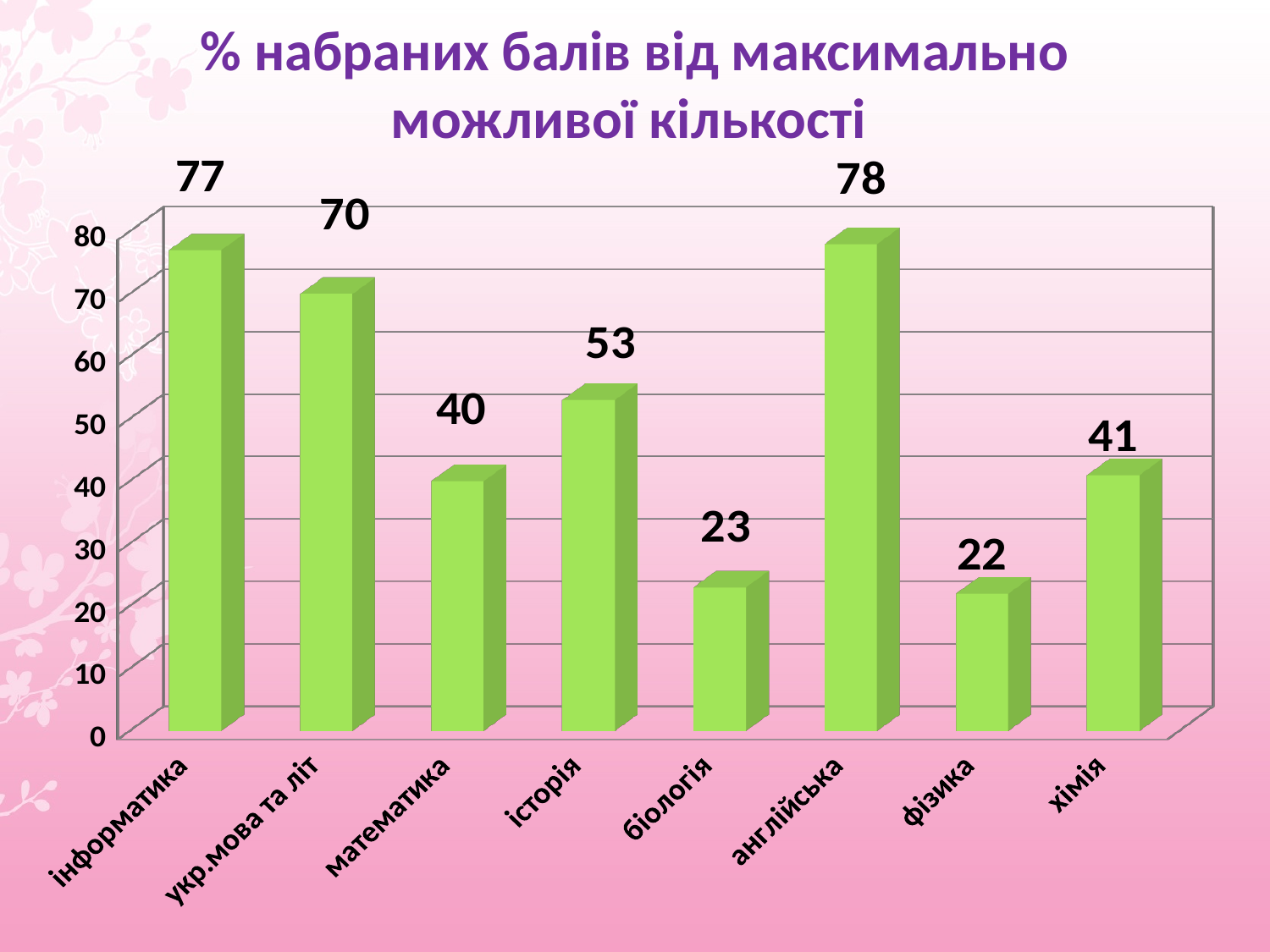
Which category has the highest value? англійська What is the difference between the values for укр.мова та літ and математика? 30 What kind of chart is shown on the slide? bar chart Which category has the lowest value? фізика What is the value for біологія? 23 What is the value for хімія? 41 How many categories are shown on the x axis? 8 What colour are the bars in the chart? green Is the value for математика greater or less than 50? less Which is larger, the value for історія or the value for хімія? історія What is the title of the chart? % набраних балів від максимально можливої кількості What is the value for інформатика? 77